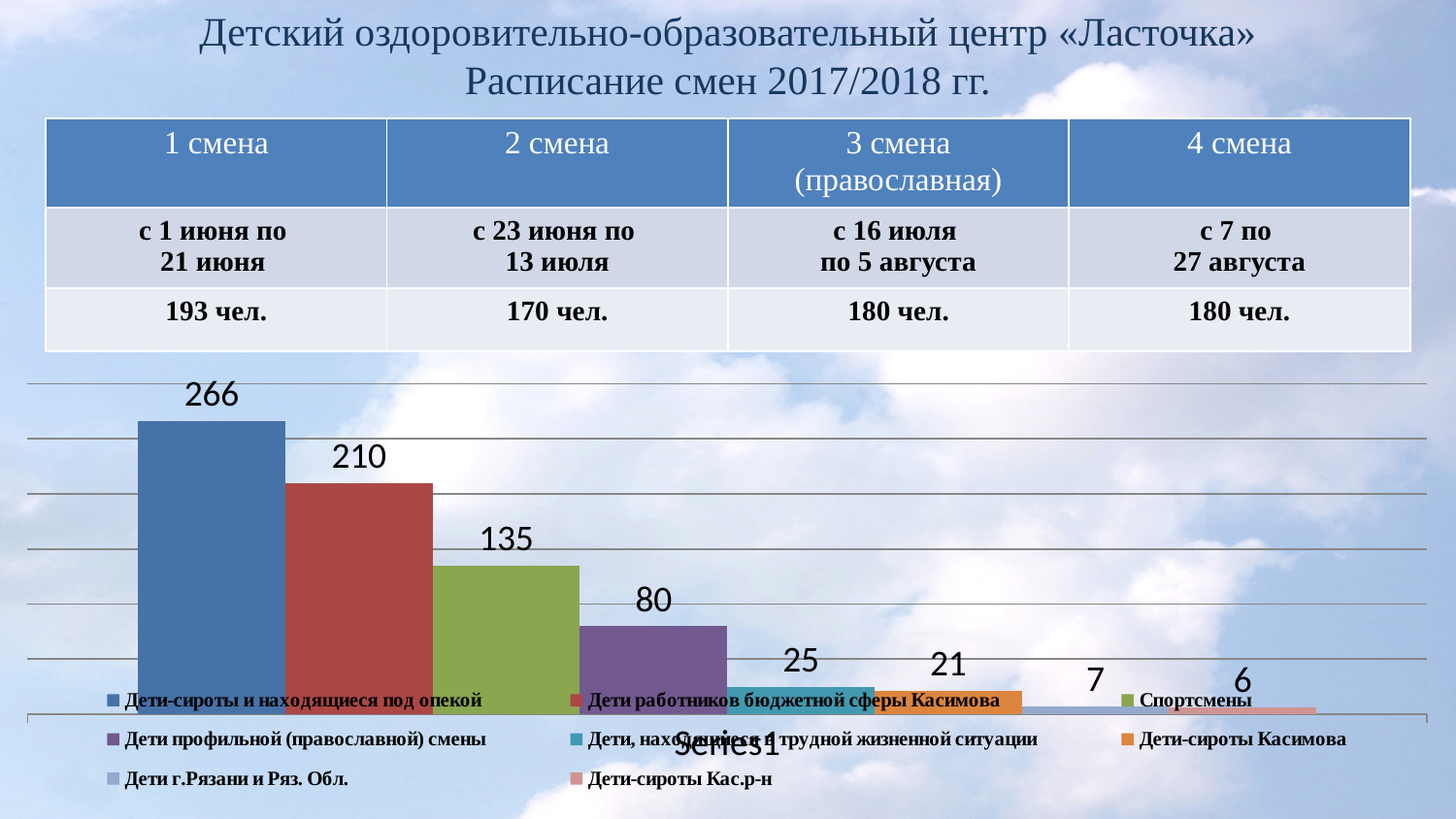
How many series does the legend list? 8 Which series has the highest value? Дети-сироты и находящиеся под опекой What is the value for «Дети работников бюджетной сферы Касимова»? 210 What type of chart is shown on the slide? bar chart What is the value for «Дети-сироты Касимова»? 21 What is the value for «Дети-сироты и находящиеся под опекой»? 266 What is the value for «Спортсмены»? 135 What is the value for «Дети профильной (православной) смены»? 80 What is the difference between the values for «Дети г.Рязани и Ряз. Обл.» and «Дети-сироты Кас.р-н»? 1 Which series has the lowest value? Дети-сироты Кас.р-н Which is larger: the value for «Спортсмены» or the value for «Дети профильной (православной) смены»? Спортсмены What is the difference between the values for «Дети-сироты и находящиеся под опекой» and «Дети работников бюджетной сферы Касимова»? 56